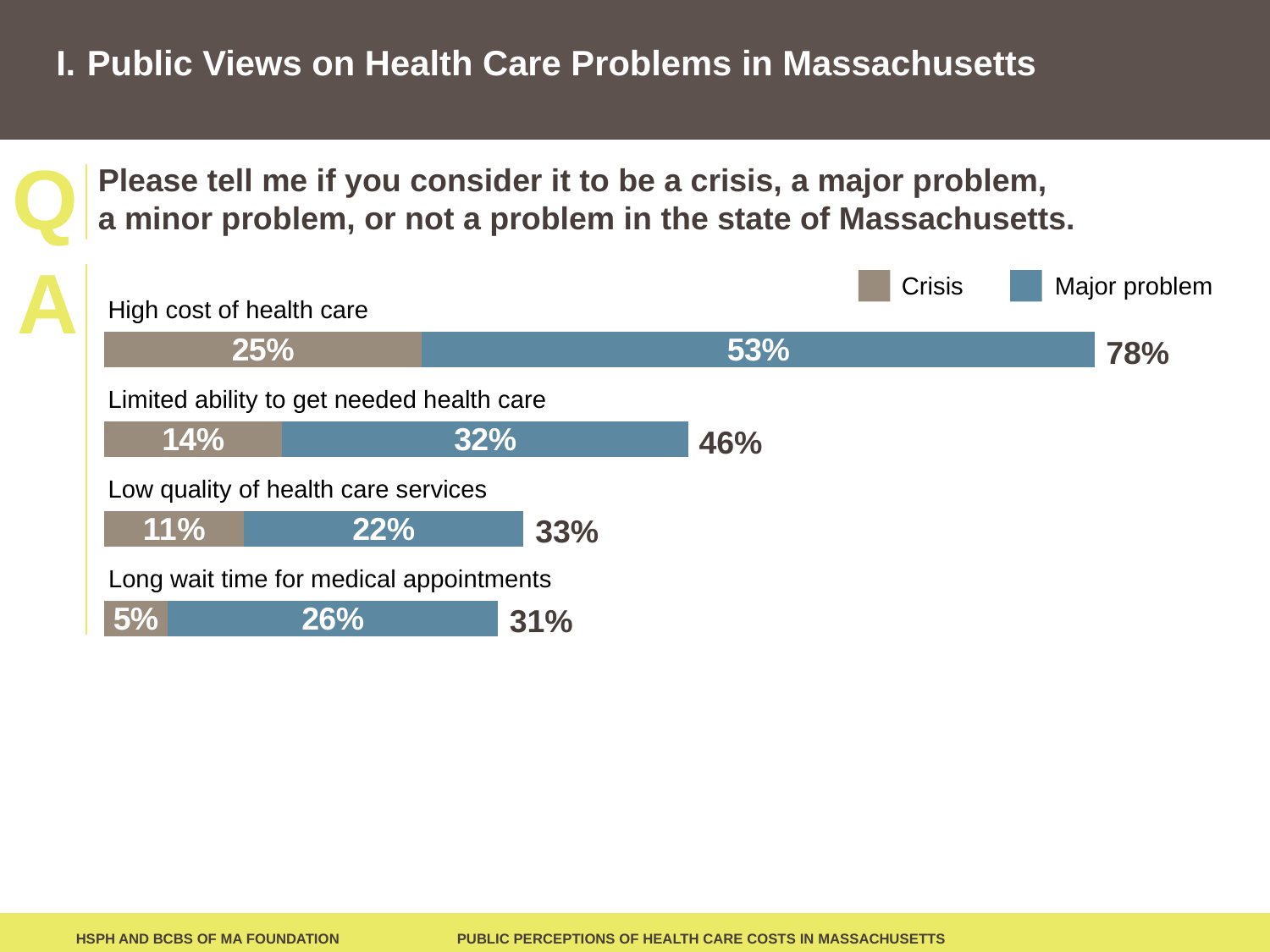
What is the difference between the 'Major problem' percentages for high cost of health care and low quality of health care services? 31% What are the two series named in the legend? Crisis and Major problem Which issue has the lowest combined crisis-plus-major-problem total? Long wait time for medical appointments What percentage of respondents consider the high cost of health care to be a crisis? 25% What percentage of respondents consider long wait time for medical appointments to be a major problem? 26% What is the combined crisis-plus-major-problem total shown for limited ability to get needed health care? 46% Which is larger: the 'Crisis' percentage for limited ability to get needed health care or for low quality of health care services? Limited ability to get needed health care What kind of chart is shown on the slide? Stacked bar chart How many series does the legend list? 2 Which issue has the highest combined crisis-plus-major-problem total? High cost of health care What is the difference between the combined totals for high cost of health care and long wait time for medical appointments? 47% How many issues (categories) are shown in the chart? 4